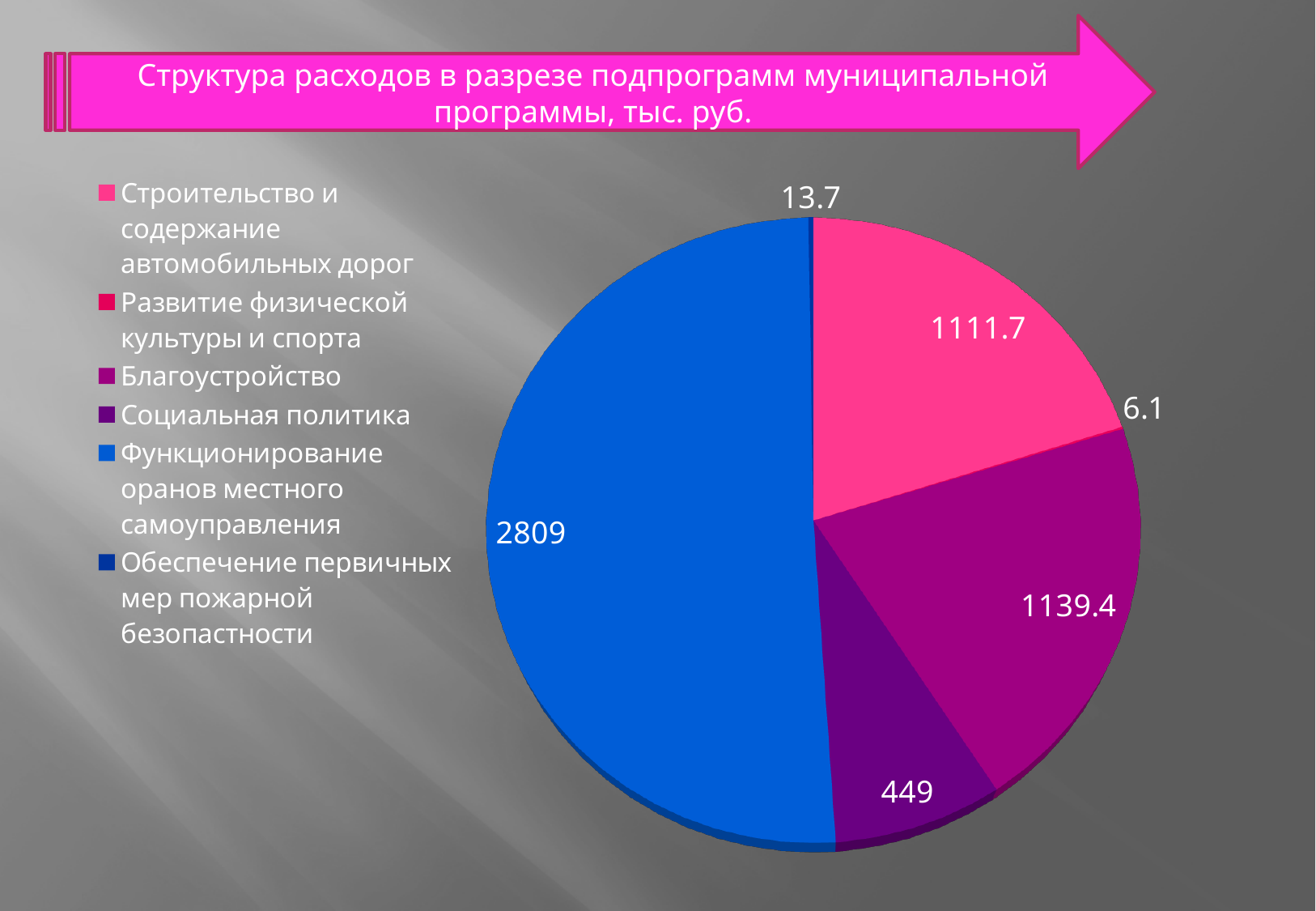
Which category has the largest slice of the pie? Функционирование оранов местного самоуправления What is the value for Социальная политика? 449 Which category has the smallest slice of the pie? Развитие физической культуры и спорта What is the value for Строительство и содержание автомобильных дорог? 1111.7 What is the value for Обеспечение первичных мер пожарной безопастности? 13.7 What is the difference between the values for Благоустройство and Строительство и содержание автомобильных дорог? 27.7 What is the difference between the values for Функционирование оранов местного самоуправления and Социальная политика? 2360 What is the value for Функционирование оранов местного самоуправления? 2809 What is the value for Благоустройство? 1139.4 Which is larger: the value for Обеспечение первичных мер пожарной безопастности or the value for Развитие физической культуры и спорта? Обеспечение первичных мер пожарной безопастности How many categories does the pie chart have? 6 What type of chart is shown on the slide? Pie chart